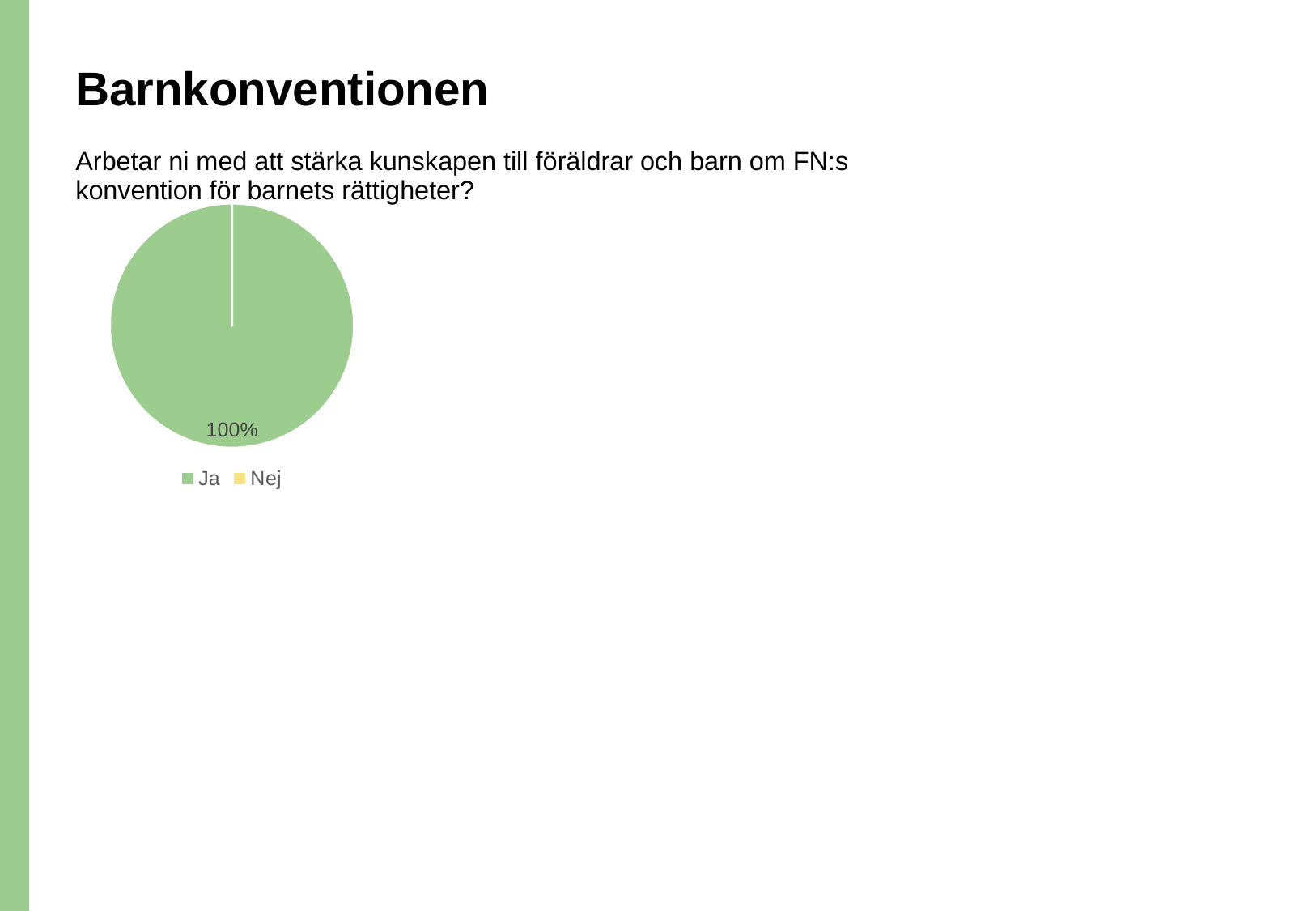
How many entries does the legend list? 2 Which category has the smallest share of the pie? Nej What share of the pie does "Ja" represent? 100% What colour is used for "Nej" in the legend? yellow Which is larger, the share for "Ja" or the share for "Nej"? Ja What kind of chart is shown on the slide? pie chart What is the only data label printed on the pie chart? 100% Which category has the largest share of the pie? Ja What colour is used for "Ja" in the chart? green